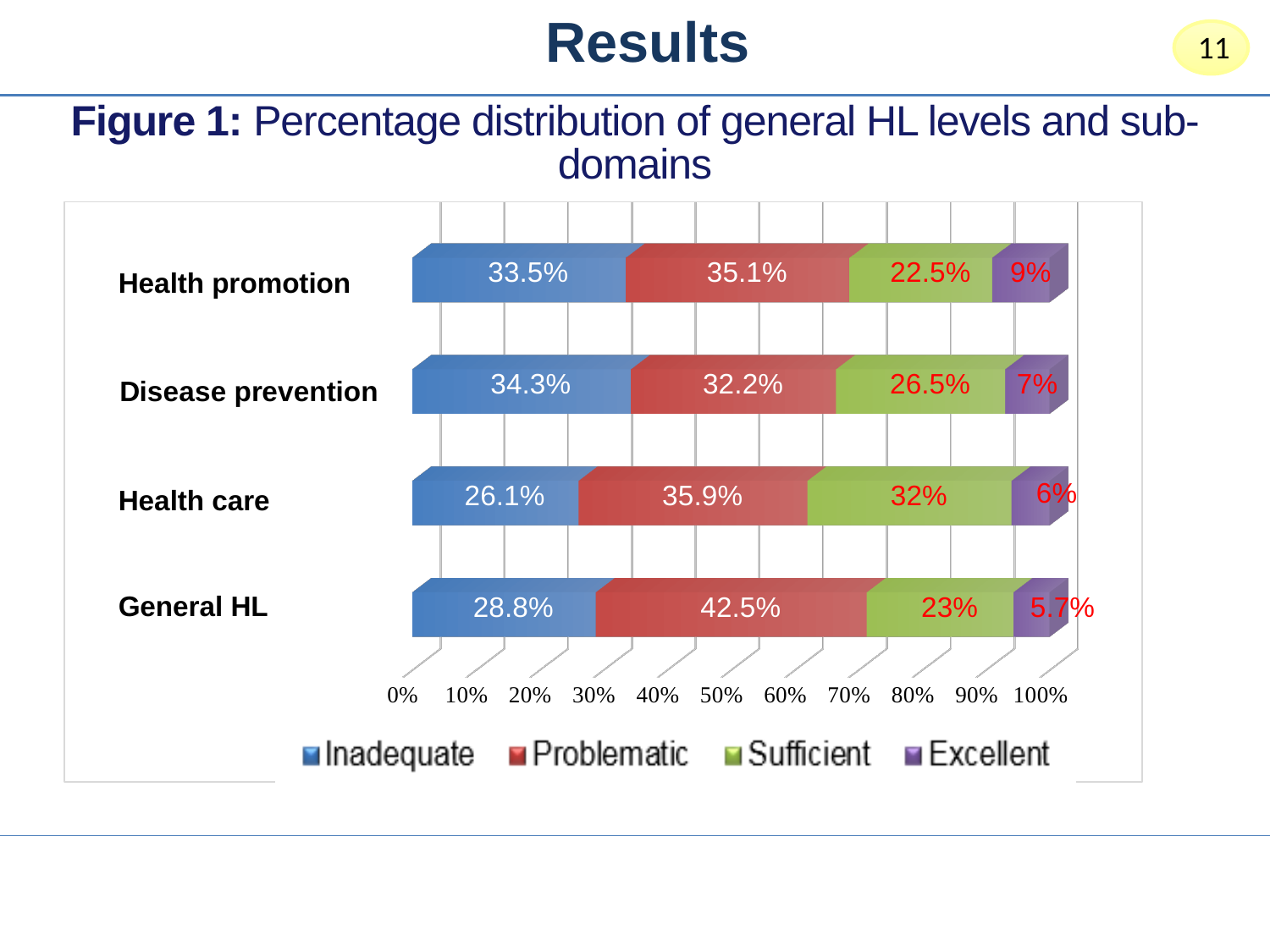
What is the Inadequate value for Health promotion? 33.5% What is the Sufficient value for Health care? 32% What is the Excellent value for Disease prevention? 7% Which is larger, the Inadequate value for Disease prevention or the Inadequate value for General HL? Disease prevention What kind of chart is shown? Stacked bar chart What is the difference between the Sufficient values for Health care and Health promotion? 9.5% How many series does the legend list? 4 Which series is shown in purple in the legend? Excellent What is the Problematic value for General HL? 42.5% Which category has the lowest Inadequate value? Health care Which category has the highest Problematic value? General HL How many categories are shown on the y axis? 4